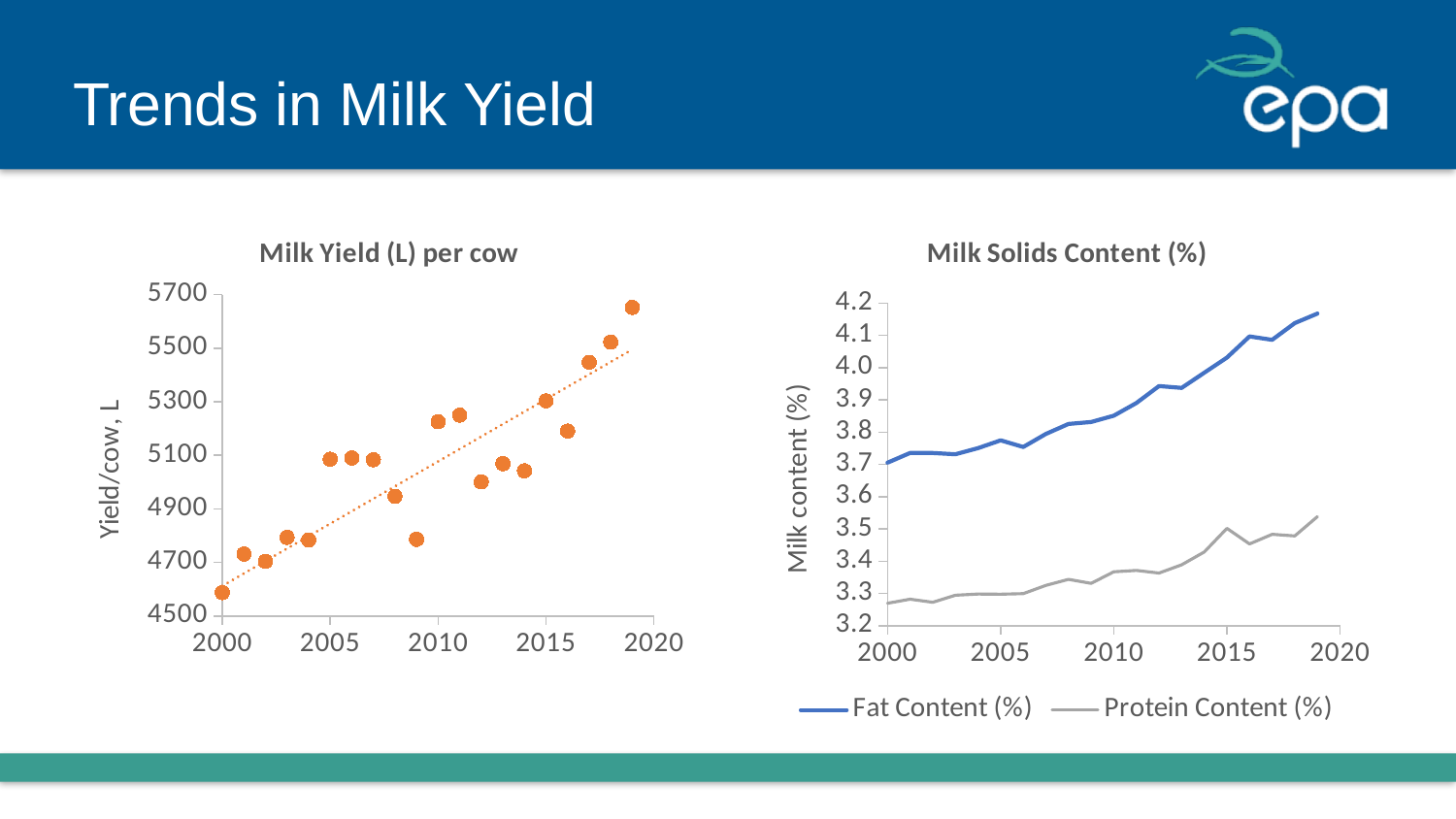
What type of chart is the 'Milk Yield (L) per cow' chart? scatter chart In the 'Milk Yield (L) per cow' chart, is the value for 2000 greater or less than 4700? less In the 'Milk Solids Content (%)' chart, which series has the higher value in 2019, Fat Content (%) or Protein Content (%)? Fat Content (%) In the 'Milk Solids Content (%)' chart, what are the two series named in the legend? Fat Content (%) and Protein Content (%) What type of chart is the 'Milk Solids Content (%)' chart? line chart In the 'Milk Solids Content (%)' chart, how many series does the legend list? 2 In the 'Milk Solids Content (%)' chart, does the Protein Content (%) series rise or fall from 2000 to 2019? rise In the 'Milk Yield (L) per cow' chart, is the value for 2019 greater or less than 5500? greater In the 'Milk Yield (L) per cow' chart, do the values generally rise or fall from 2000 to 2020? rise In the 'Milk Yield (L) per cow' chart, which year has the lowest yield? 2000 In the 'Milk Solids Content (%)' chart, is the Fat Content (%) value for 2019 greater or less than 4.1? greater In the 'Milk Yield (L) per cow' chart, which year has the highest yield? 2019